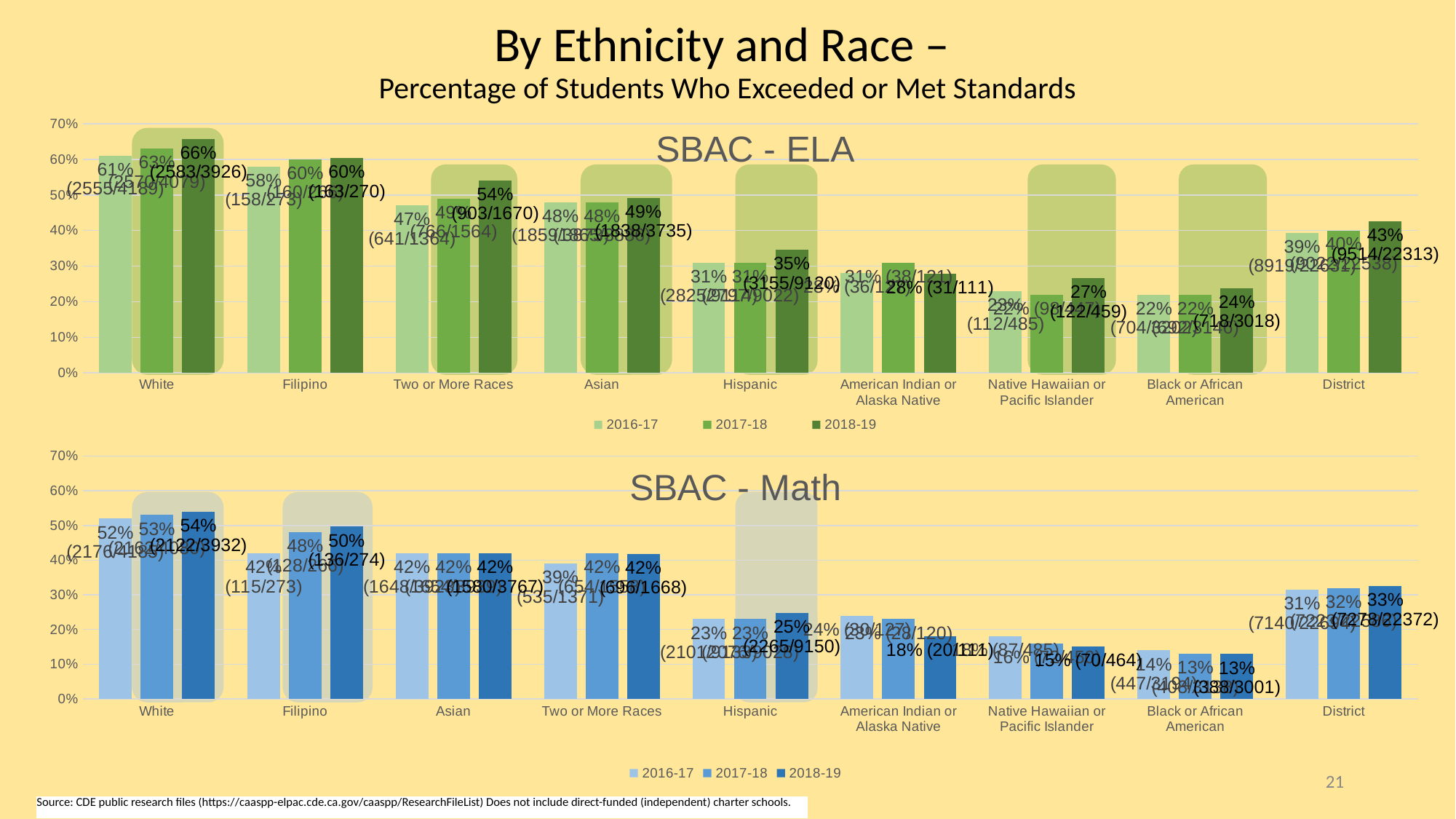
In the SBAC - ELA chart, is the 2016-17 value for Native Hawaiian or Pacific Islander students greater or less than 30%? less In the SBAC - ELA chart, what is the difference between the 2018-19 values for White and Filipino students? 6% In the SBAC - Math chart, what is the 2018-19 value for Black or African American students? 13% In the SBAC - Math chart, which is larger for 2018-19: the value for Filipino students or the value for the District? Filipino How many categories are shown on the x axis of the SBAC - Math chart? 9 In the SBAC - ELA chart, which category has the highest 2018-19 value? White In the SBAC - Math chart, which category has the lowest 2018-19 value? Black or African American In the SBAC - ELA chart, what is the 2018-19 value for White students? 66% In the SBAC - Math chart, what is the 2018-19 value for Hispanic students? 25% In the SBAC - ELA chart, what is the 2018-19 value for the District? 43% What type of chart is the SBAC - Math chart? Bar chart How many series does the legend of the SBAC - ELA chart list? 3